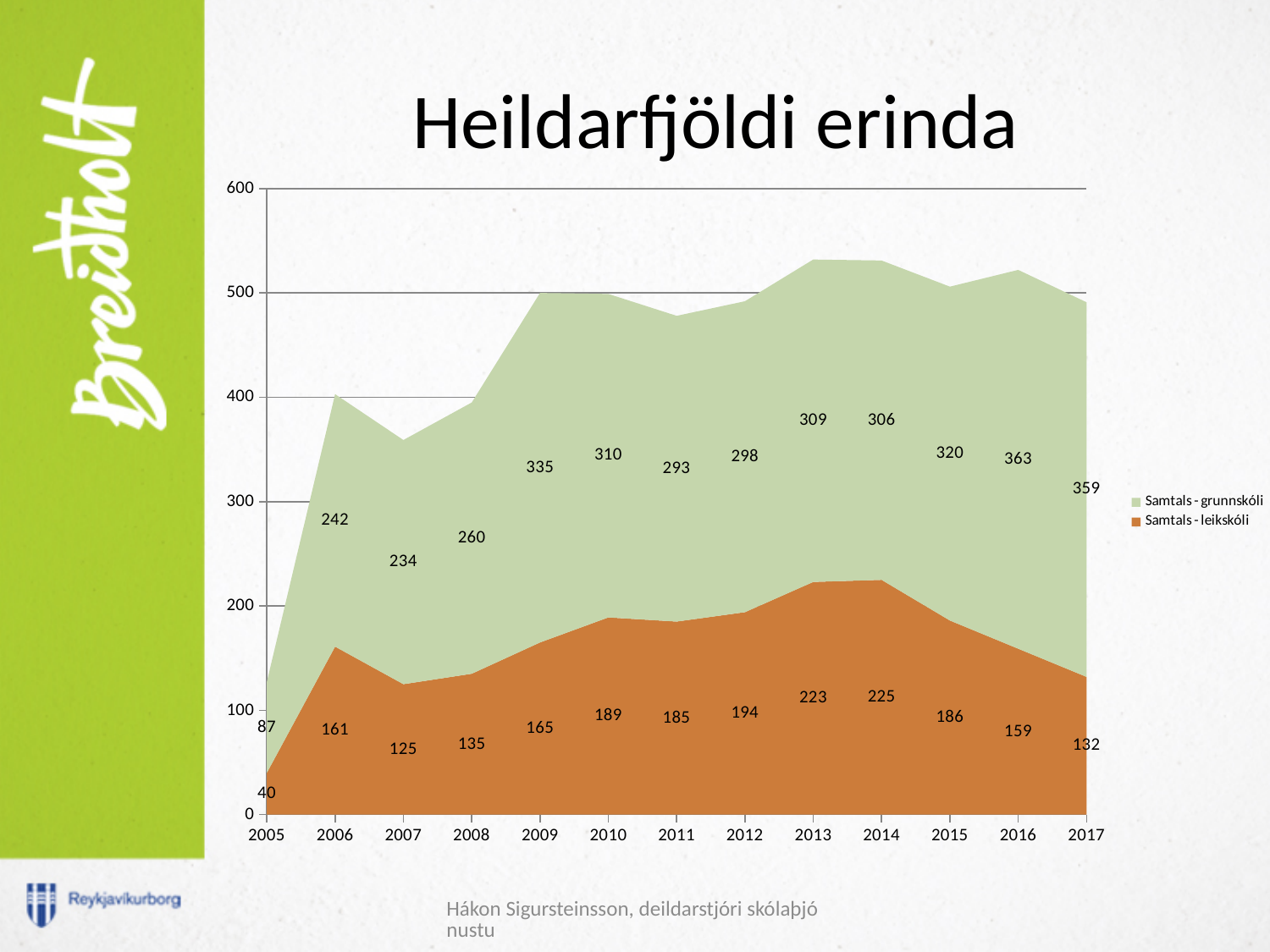
In which year is the Samtals - grunnskóli value highest? 2016 What is the value for Samtals - leikskóli in 2014? 225 What is the difference between the Samtals - grunnskóli values for 2009 and 2008? 75 What kind of chart is shown on the slide? Stacked area chart In which year is the Samtals - leikskóli value lowest? 2005 What is the value for Samtals - leikskóli in 2005? 40 How many series does the legend list? 2 How many years are shown on the x axis? 13 Which is larger, the Samtals - leikskóli value for 2013 or for 2015? 2013 What is the title of the chart? Heildarfjöldi erinda What is the value for Samtals - grunnskóli in 2016? 363 What is the combined total of Samtals - grunnskóli and Samtals - leikskóli in 2013? 532